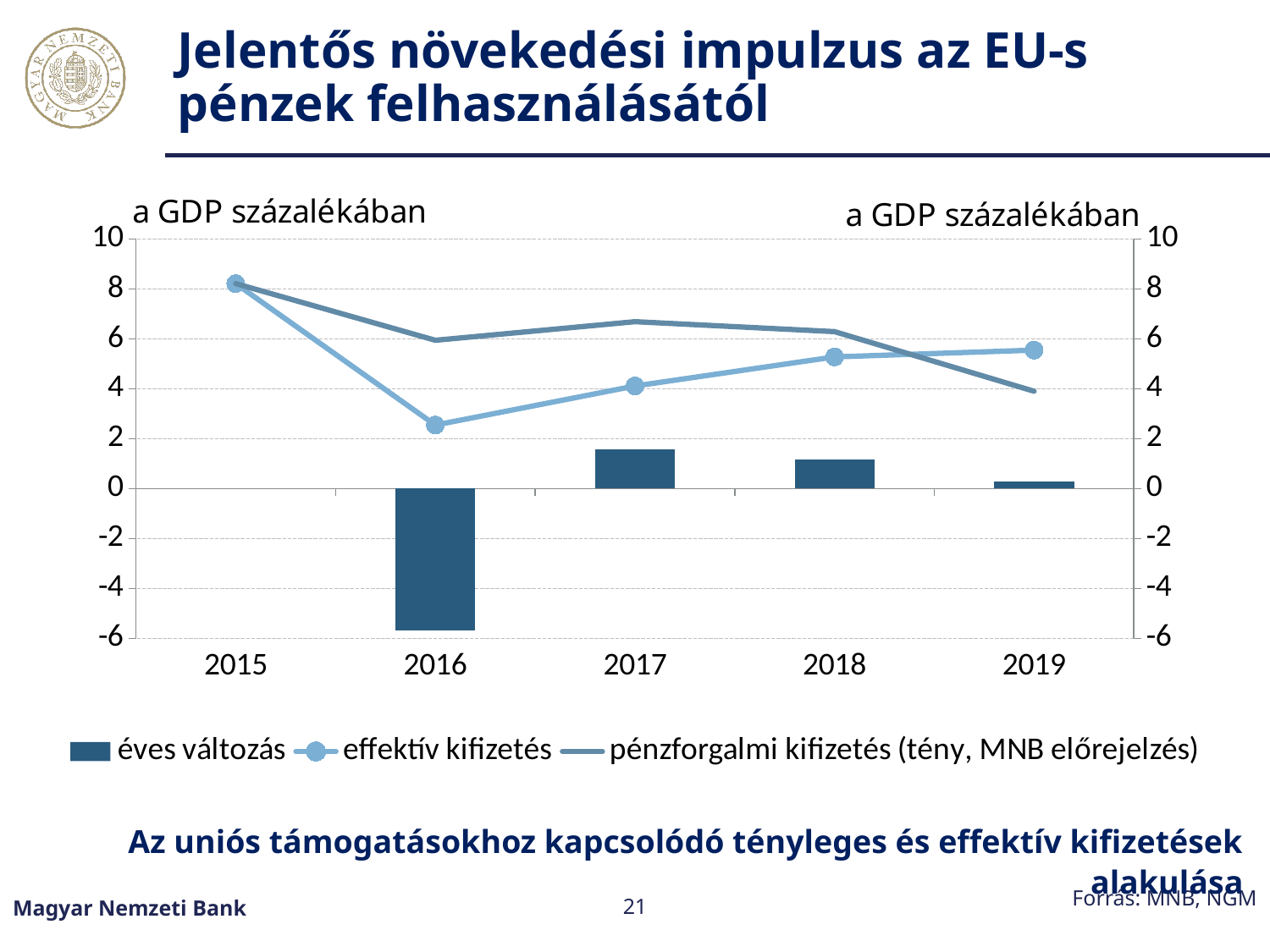
Is the value of 'pénzforgalmi kifizetés (tény, MNB előrejelzés)' in 2017 greater or less than 6? greater Is the 'éves változás' bar for 2016 greater or less than -4? less Is the value of 'effektív kifizetés' in 2016 greater or less than 4? less In which year is the 'effektív kifizetés' series at its lowest? 2016 In which year is the 'effektív kifizetés' series at its highest? 2015 What kind of chart is shown on the slide? A combined bar and line chart How many years are shown on the x axis? 5 Does the 'pénzforgalmi kifizetés (tény, MNB előrejelzés)' series rise or fall from 2017 to 2019? It falls In 2019, which is higher: 'effektív kifizetés' or 'pénzforgalmi kifizetés (tény, MNB előrejelzés)'? effektív kifizetés In which year is the 'éves változás' bar at its lowest? 2016 How many series does the legend list? 3 What unit label is shown above the vertical axes? a GDP százalékában